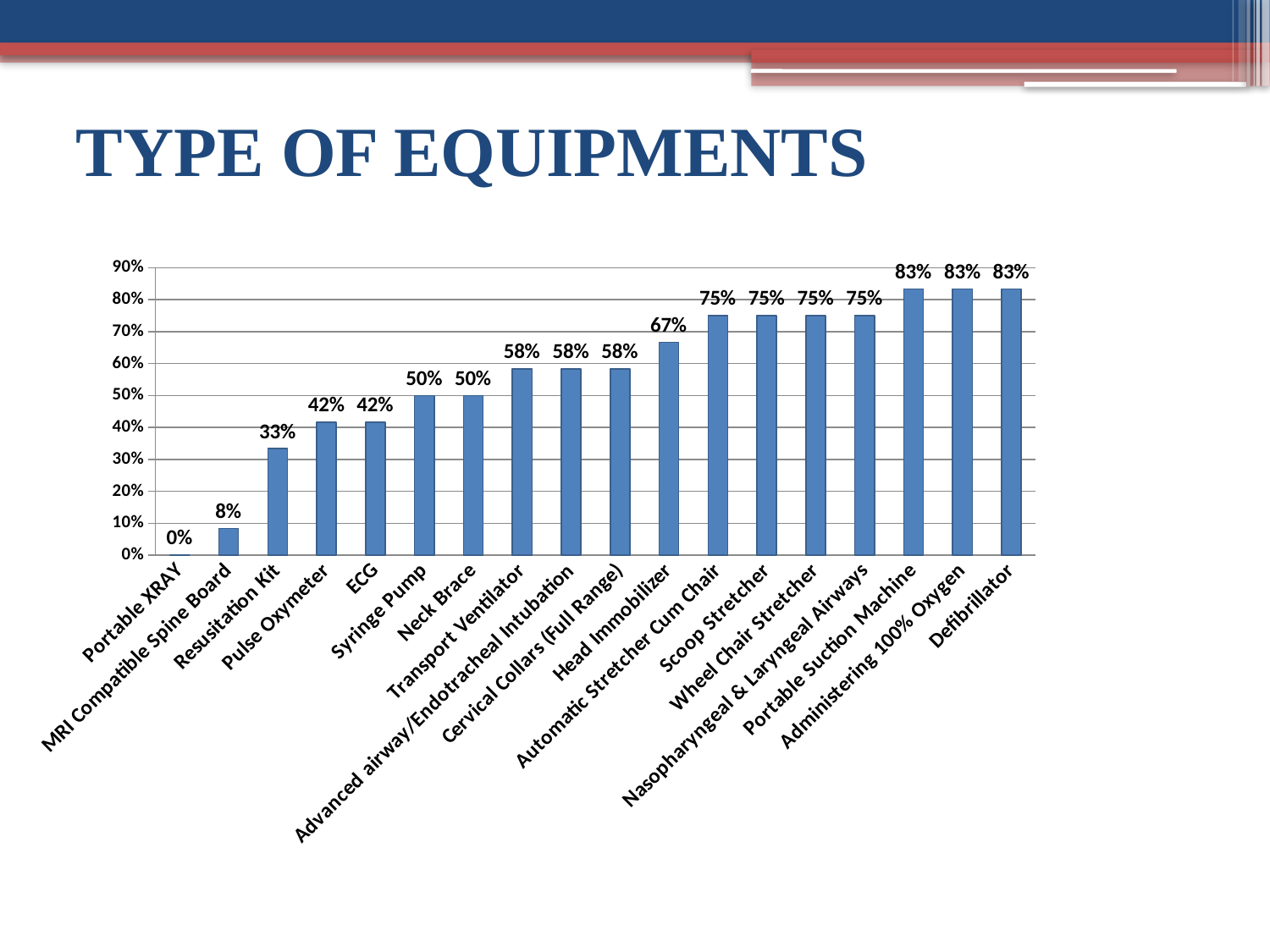
Which is larger, the value for Transport Ventilator or the value for ECG? Transport Ventilator What is the value for Defibrillator? 83% Do the values rise or fall from left to right along the x axis? Rise What is the value for Head Immobilizer? 67% Which category has the lowest value? Portable XRAY What kind of chart is shown on the slide? Bar chart How many categories are shown on the x axis? 18 What is the difference between the values for Portable Suction Machine and Head Immobilizer? 16% What is the value for Resusitation Kit? 33% What is the difference between the values for Scoop Stretcher and Resusitation Kit? 42% What is the value for Syringe Pump? 50% What is the value for MRI Compatible Spine Board? 8%